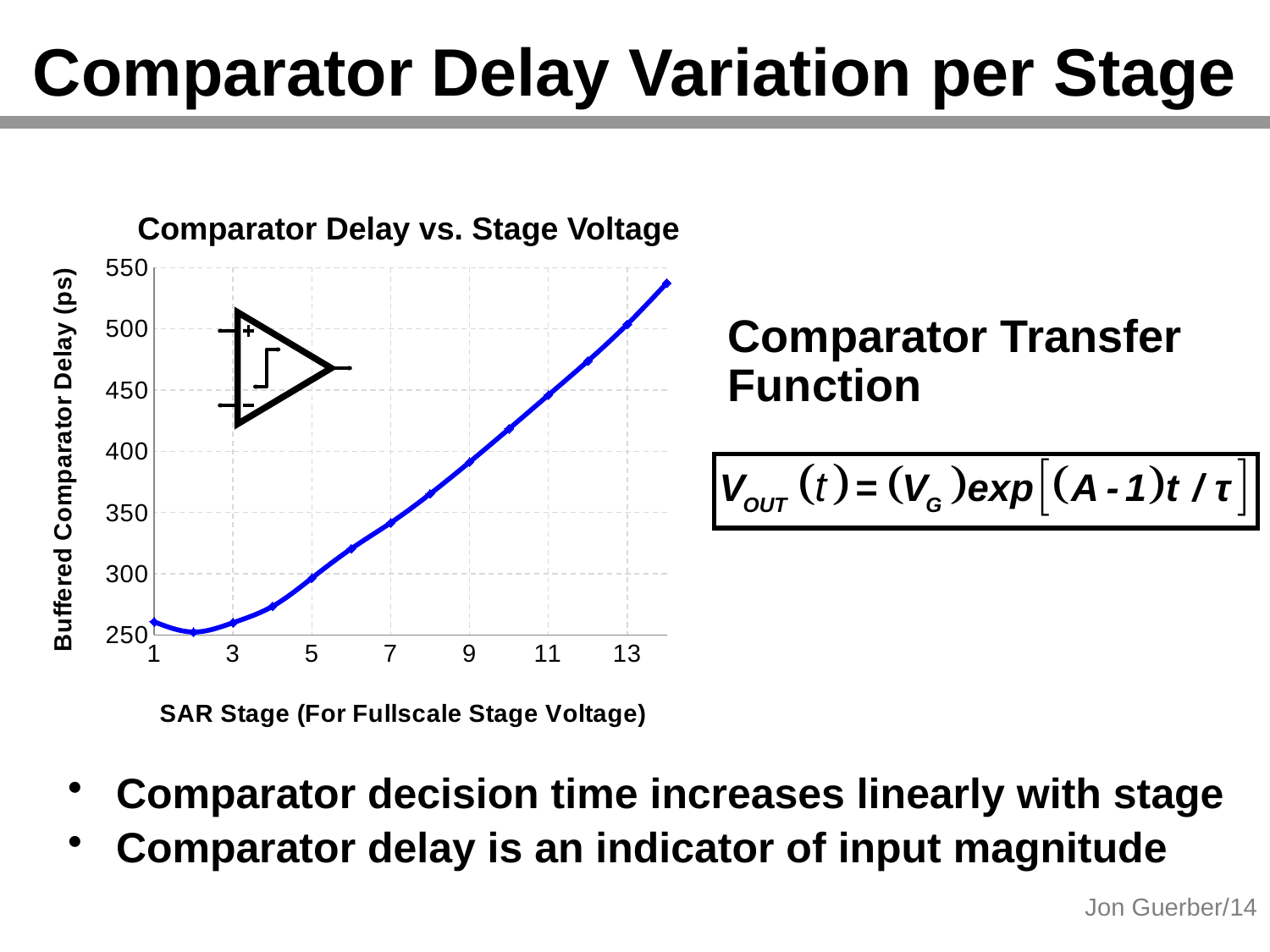
Is the buffered comparator delay at SAR stage 10 greater or less than 400? greater Is the buffered comparator delay at SAR stage 12 greater or less than 450? greater Does the buffered comparator delay generally rise or fall as the SAR stage increases? rise Is the buffered comparator delay at SAR stage 14 greater or less than 500? greater What kind of chart is shown on the slide? line chart How many data points are plotted on the line? 14 Which has the larger buffered comparator delay, SAR stage 4 or SAR stage 8? SAR stage 8 Which SAR stage has the highest buffered comparator delay? 14 What is the title of the chart? Comparator Delay vs. Stage Voltage What is the label of the y axis of the chart? Buffered Comparator Delay (ps)